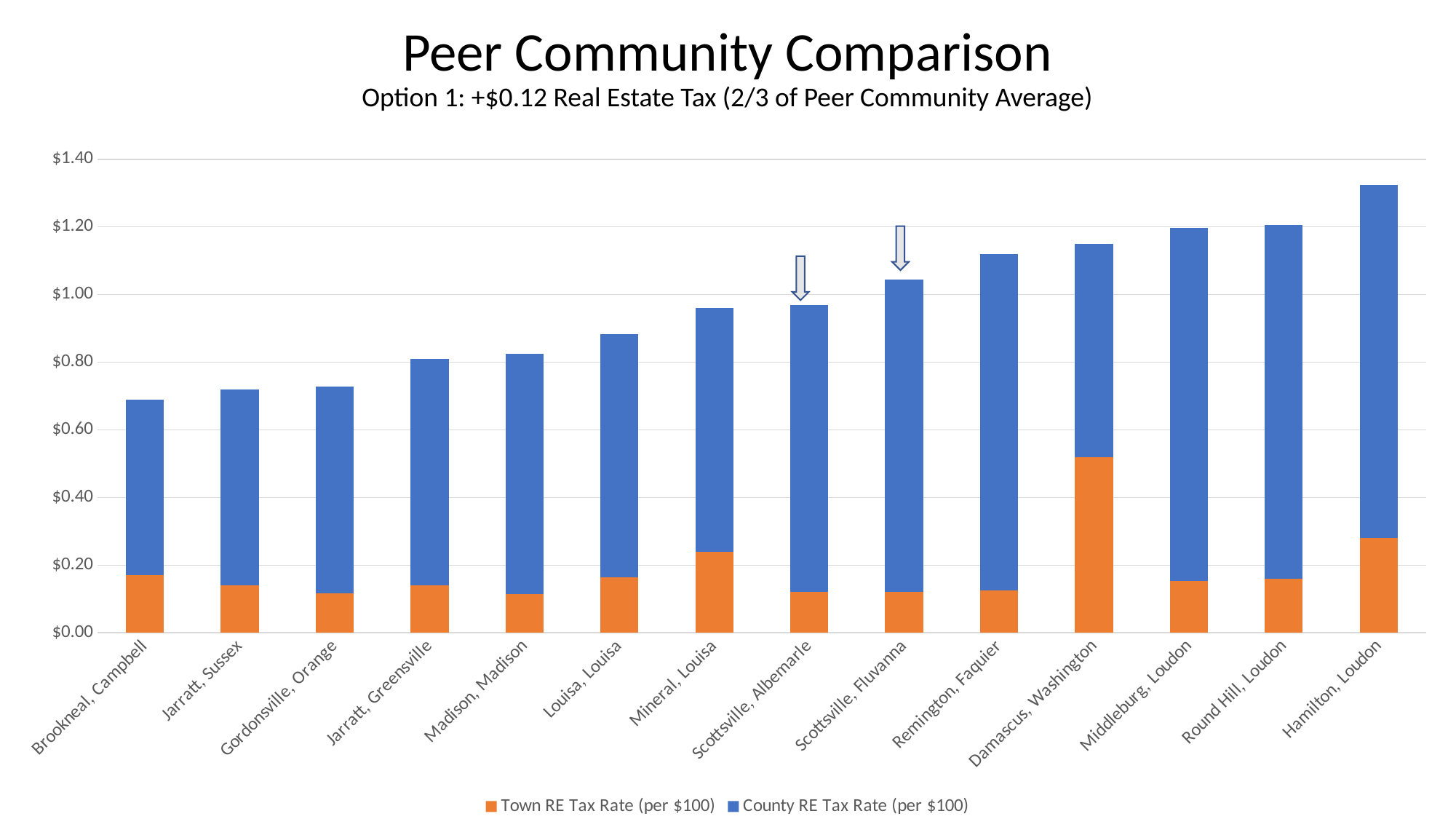
What kind of chart is shown on the slide? Stacked bar chart Is the total bar for Hamilton, Loudon greater or less than $1.20? greater Which community has the largest Town RE Tax Rate (orange) segment? Damascus, Washington Do the total bar heights generally rise or fall from left to right along the x axis? Rise Is the Town RE Tax Rate segment for Damascus, Washington greater or less than $0.40? greater How many peer communities are plotted along the x axis? 14 How many series does the legend list? 2 Is the total bar for Remington, Fauquier greater or less than $1.00? greater Which community has the lowest total bar? Brookneal, Campbell Which community has the highest total bar? Hamilton, Loudon Which has the larger total bar, Hamilton, Loudon or Brookneal, Campbell? Hamilton, Loudon